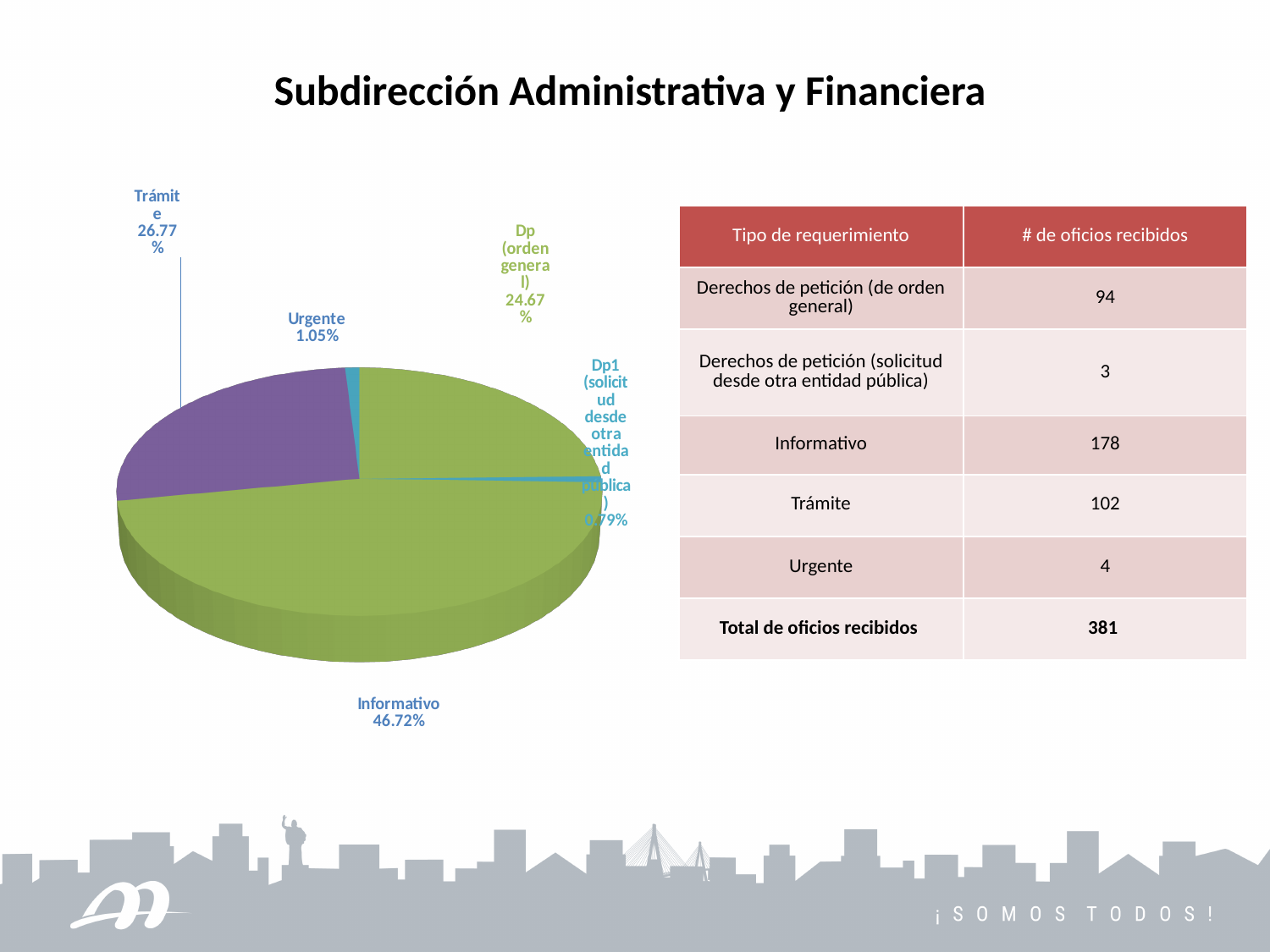
What percentage is shown for Trámite in the pie chart? 26.77% Which category has the smallest slice in the pie chart? Dp1 (solicitud desde otra entidad pública) Which slice is larger, Trámite or Dp (orden general)? Trámite What colour is the Informativo slice in the pie chart? green Which category has the largest slice in the pie chart? Informativo What is the difference in percentage points between the Informativo and Trámite slices? 19.95% What kind of chart is shown on the slide? pie chart What percentage does the Informativo slice represent in the pie chart? 46.72% What percentage is shown for Dp1 (solicitud desde otra entidad pública) in the pie chart? 0.79% What percentage is shown for Dp (orden general) in the pie chart? 24.67% What percentage is shown for Urgente in the pie chart? 1.05% How many slices does the pie chart have? 5